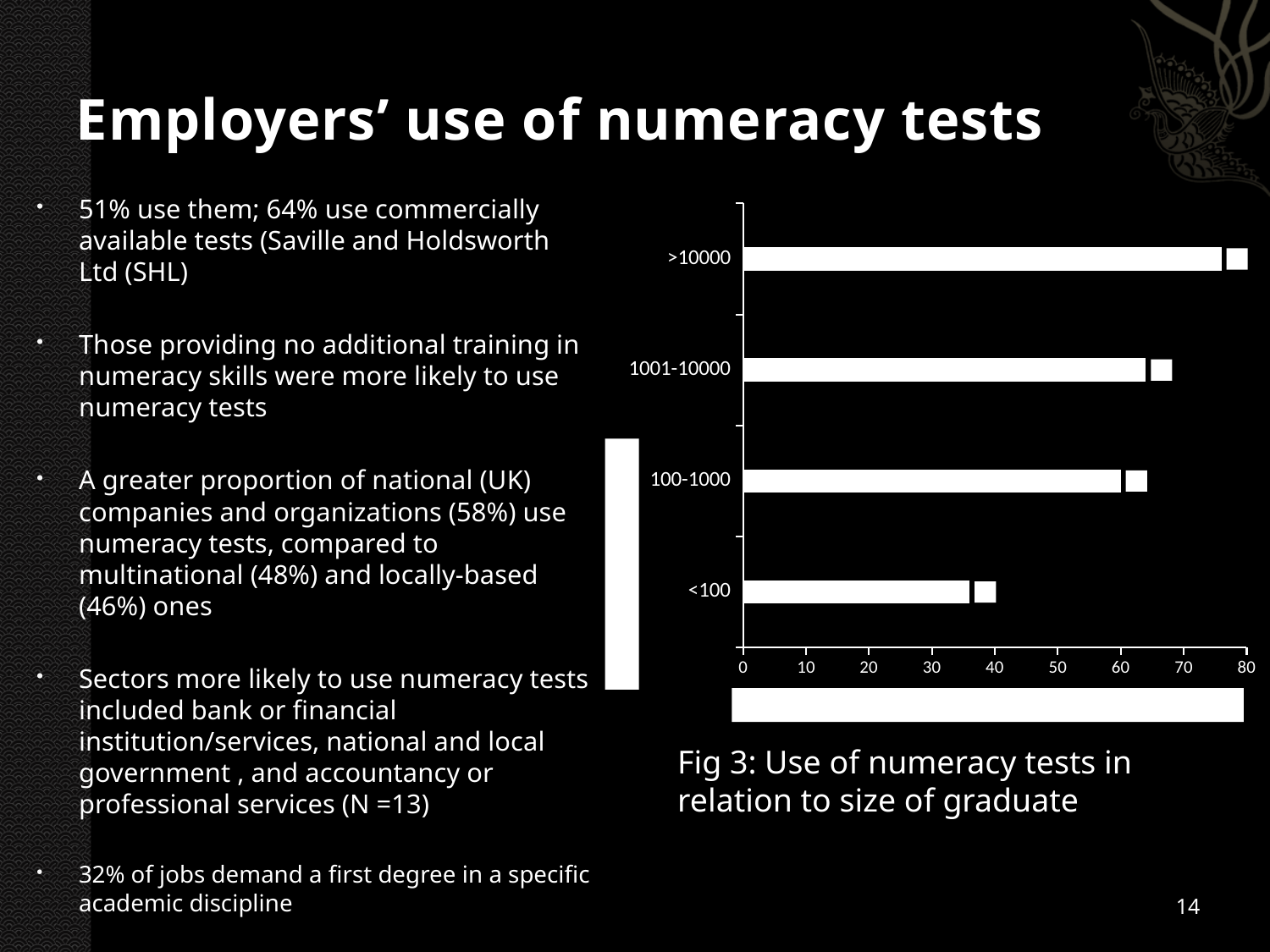
How many categories are plotted on the chart? 4 Is the value for <100 greater or less than 40? less What kind of chart is shown on the slide? bar chart Is the value for 1001-10000 greater or less than 70? less Which category has the lowest value on the chart? <100 Which category has the highest value on the chart? >10000 Is the value for >10000 greater or less than 70? greater Do the values increase or decrease as the size category goes from <100 up to >10000? increase What is the caption given for the chart? Fig 3: Use of numeracy tests in relation to size of graduate Which is larger, the value for >10000 or the value for <100? >10000